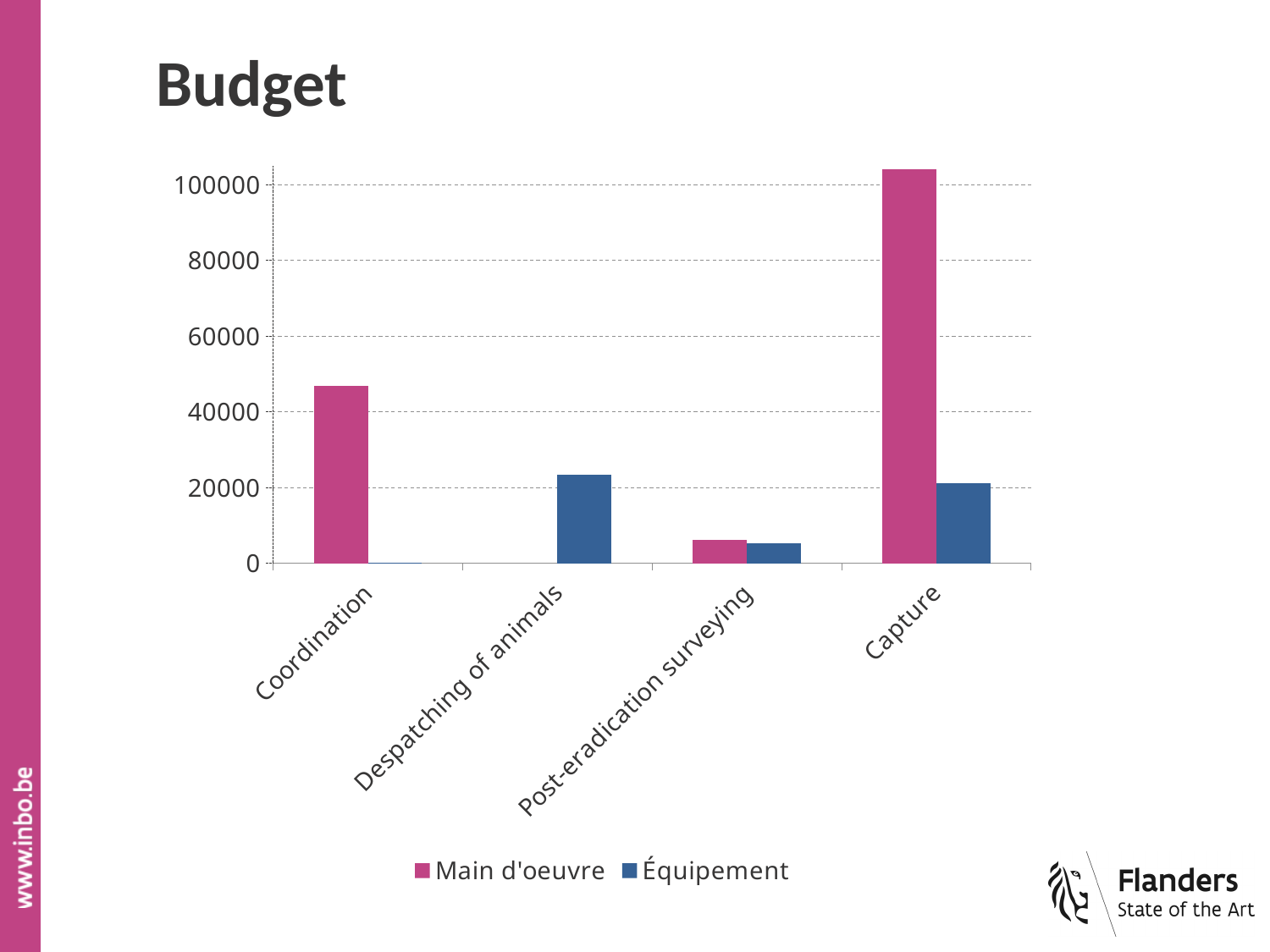
Is the Main d'oeuvre value for Capture greater or less than 100000? greater How many series does the legend list? 2 What kind of chart is shown on the slide? bar chart How many categories are shown on the x axis of the chart? 4 Which category has the highest Équipement value? Despatching of animals Which category has the highest Main d'oeuvre value? Capture Which is larger for Capture: Main d'oeuvre or Équipement? Main d'oeuvre Is the Main d'oeuvre value for Coordination greater or less than 40000? greater What is the title of the slide containing the chart? Budget Which is larger: the Main d'oeuvre value for Coordination or the Main d'oeuvre value for Capture? Capture Is the Équipement value for Despatching of animals greater or less than 20000? greater